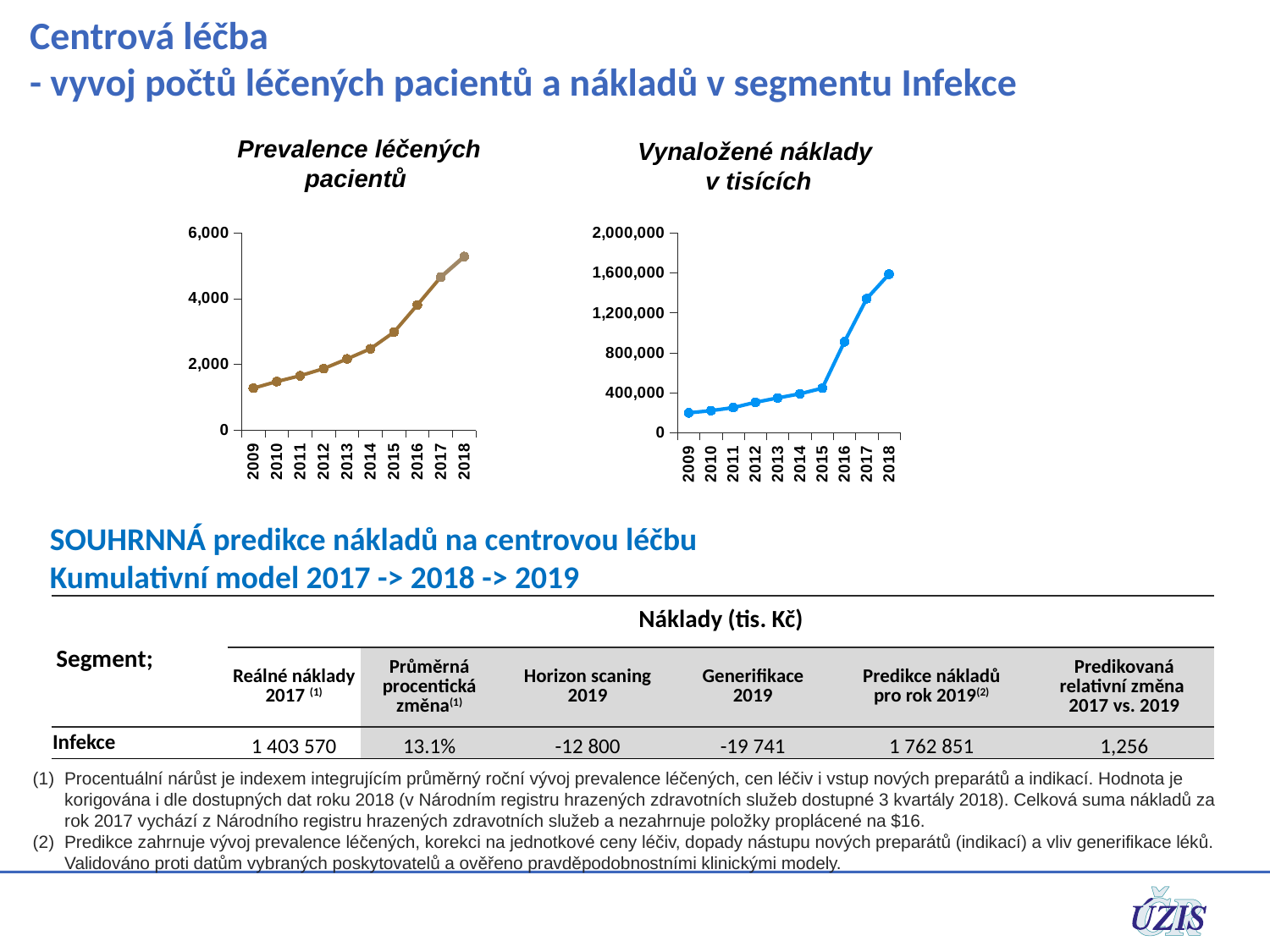
In the left chart 'Prevalence léčených pacientů', is the value for 2009 greater or less than 2,000? less In the left chart 'Prevalence léčených pacientů', which year has the highest value? 2018 In the right chart 'Vynaložené náklady v tisících', which year has the lowest value? 2009 In the left chart 'Prevalence léčených pacientů', do the values rise or fall from 2009 to 2018? rise In the right chart 'Vynaložené náklady v tisících', is the value for 2009 greater or less than 400,000? less In the left chart 'Prevalence léčených pacientů', is the value for 2018 greater or less than 4,000? greater What kind of chart is the left chart titled 'Prevalence léčených pacientů'? line chart What kind of chart is the right chart titled 'Vynaložené náklady v tisících'? line chart In the left chart 'Prevalence léčených pacientů', how many years are plotted on the x axis? 10 In the right chart 'Vynaložené náklady v tisících', how many data points are plotted? 10 In the right chart 'Vynaložené náklady v tisících', do the values rise or fall from 2009 to 2018? rise